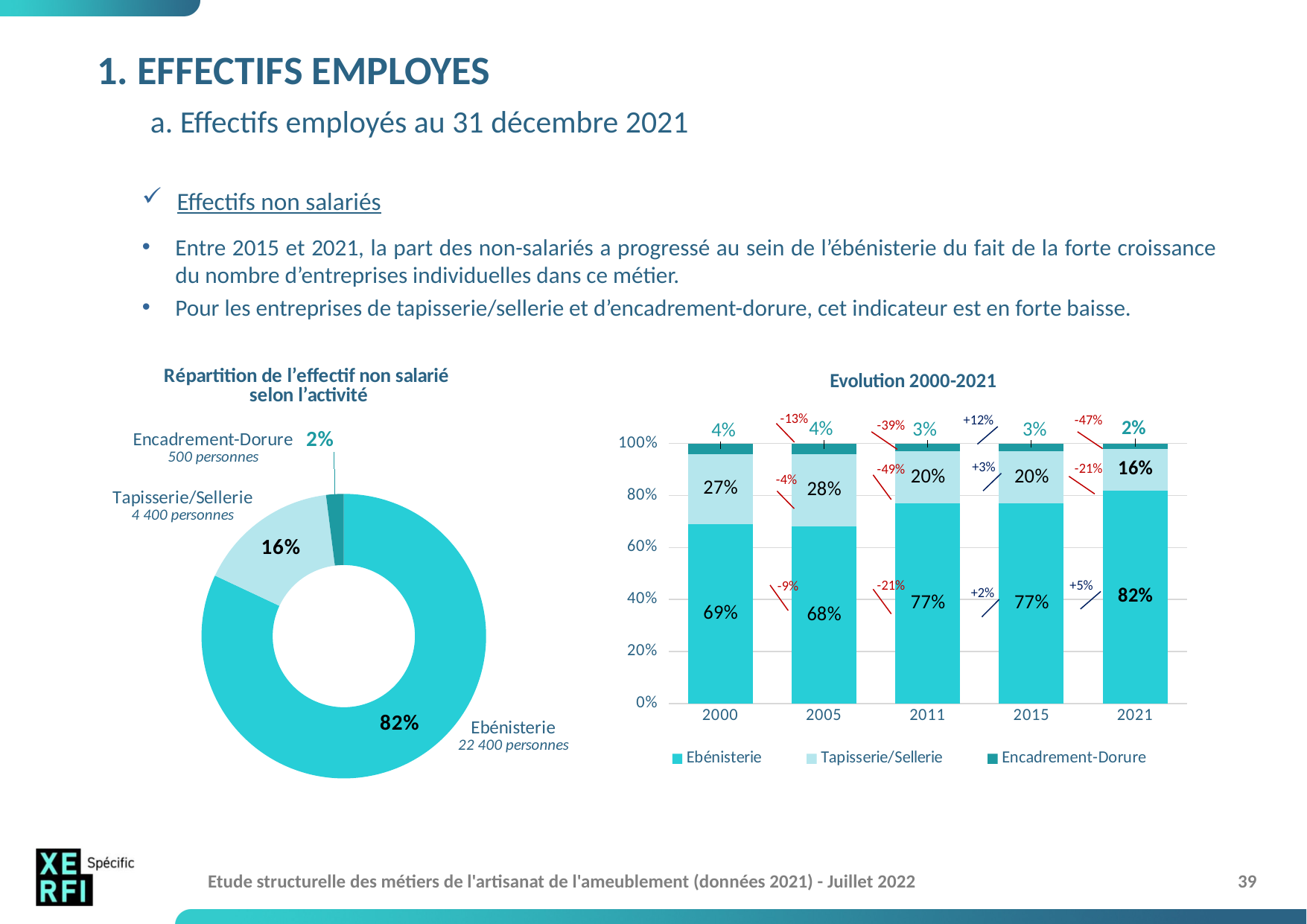
In the 'Evolution 2000-2021' chart, what is the value for Tapisserie/Sellerie in 2000? 27% In the 'Répartition de l'effectif non salarié selon l'activité' chart, what share does Ebénisterie hold? 82% In the 'Répartition de l'effectif non salarié selon l'activité' chart, how many people are in Tapisserie/Sellerie? 4 400 personnes In the 'Répartition de l'effectif non salarié selon l'activité' chart, which activity has the smallest share? Encadrement-Dorure In the 'Evolution 2000-2021' chart, what is the difference between the Ebénisterie share in 2021 and in 2000? 13 percentage points What kind of chart is 'Répartition de l'effectif non salarié selon l'activité'? Doughnut (pie) chart In the 'Evolution 2000-2021' chart, in which year is the Ebénisterie share highest? 2021 In the 'Répartition de l'effectif non salarié selon l'activité' chart, how many activities are shown? 3 In the 'Evolution 2000-2021' chart, what is the value for Ebénisterie in 2005? 68% In the 'Evolution 2000-2021' chart, how many series does the legend list? 3 In the 'Evolution 2000-2021' chart, does the Tapisserie/Sellerie share rise or fall between 2005 and 2021? Fall In the 'Evolution 2000-2021' chart, what is the value for Encadrement-Dorure in 2021? 2%